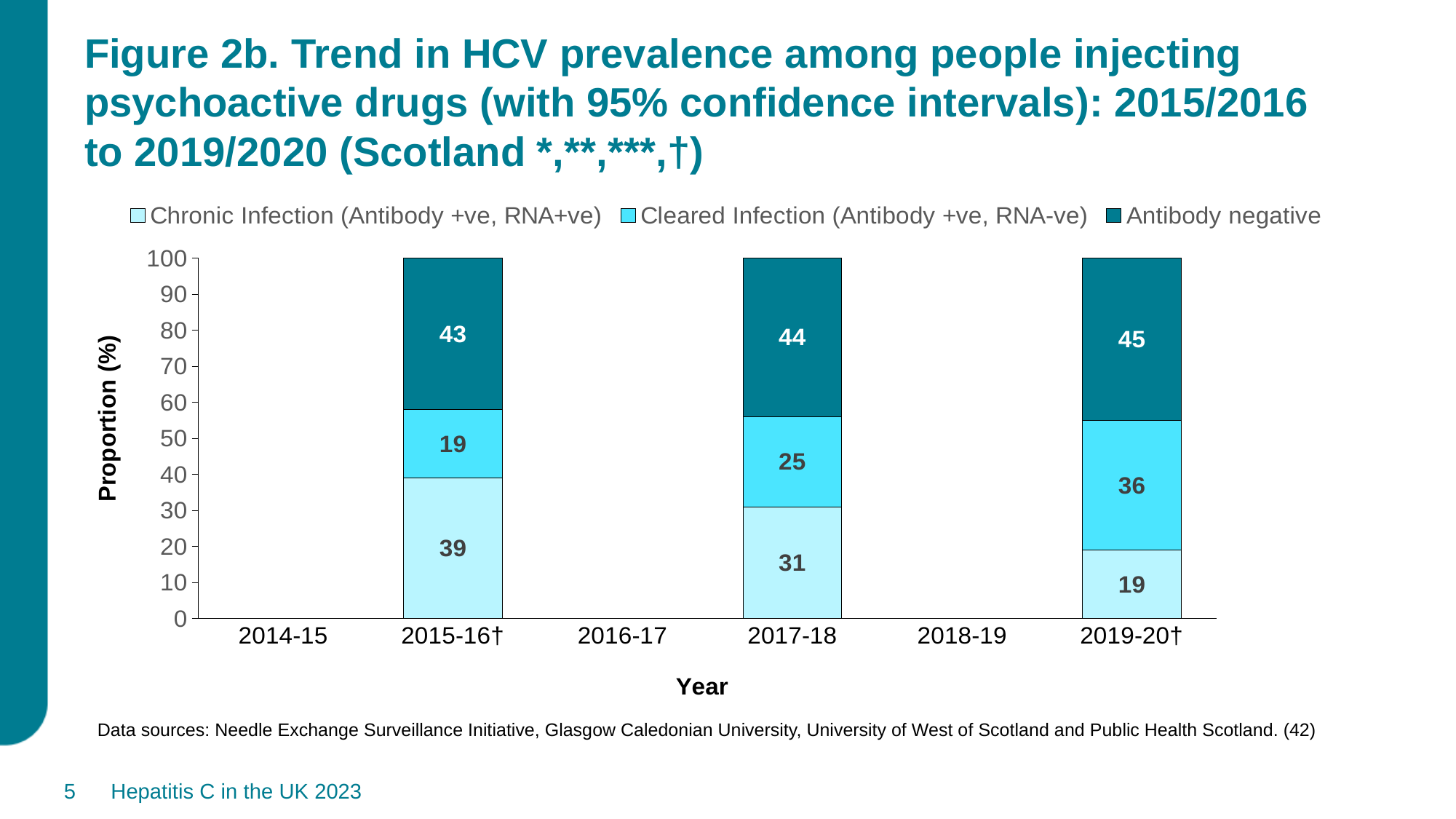
What is the Cleared Infection (Antibody +ve, RNA-ve) value for 2019-20†? 36 In which year is the Chronic Infection (Antibody +ve, RNA+ve) proportion lowest? 2019-20† What is the Antibody negative value for 2017-18? 44 How many series does the legend list? 3 Which is larger in 2017-18: the Chronic Infection value or the Cleared Infection value? Chronic Infection What is the Chronic Infection (Antibody +ve, RNA+ve) value for 2015-16†? 39 Does the Chronic Infection (Antibody +ve, RNA+ve) proportion rise or fall from 2015-16† to 2019-20†? Fall In which year is the Cleared Infection (Antibody +ve, RNA-ve) proportion highest? 2019-20† How many bars with data are plotted on the chart? 3 What kind of chart is shown on the slide? Stacked bar chart What is the difference between the Chronic Infection values for 2015-16† and 2019-20†? 20 What is the label of the y axis? Proportion (%)